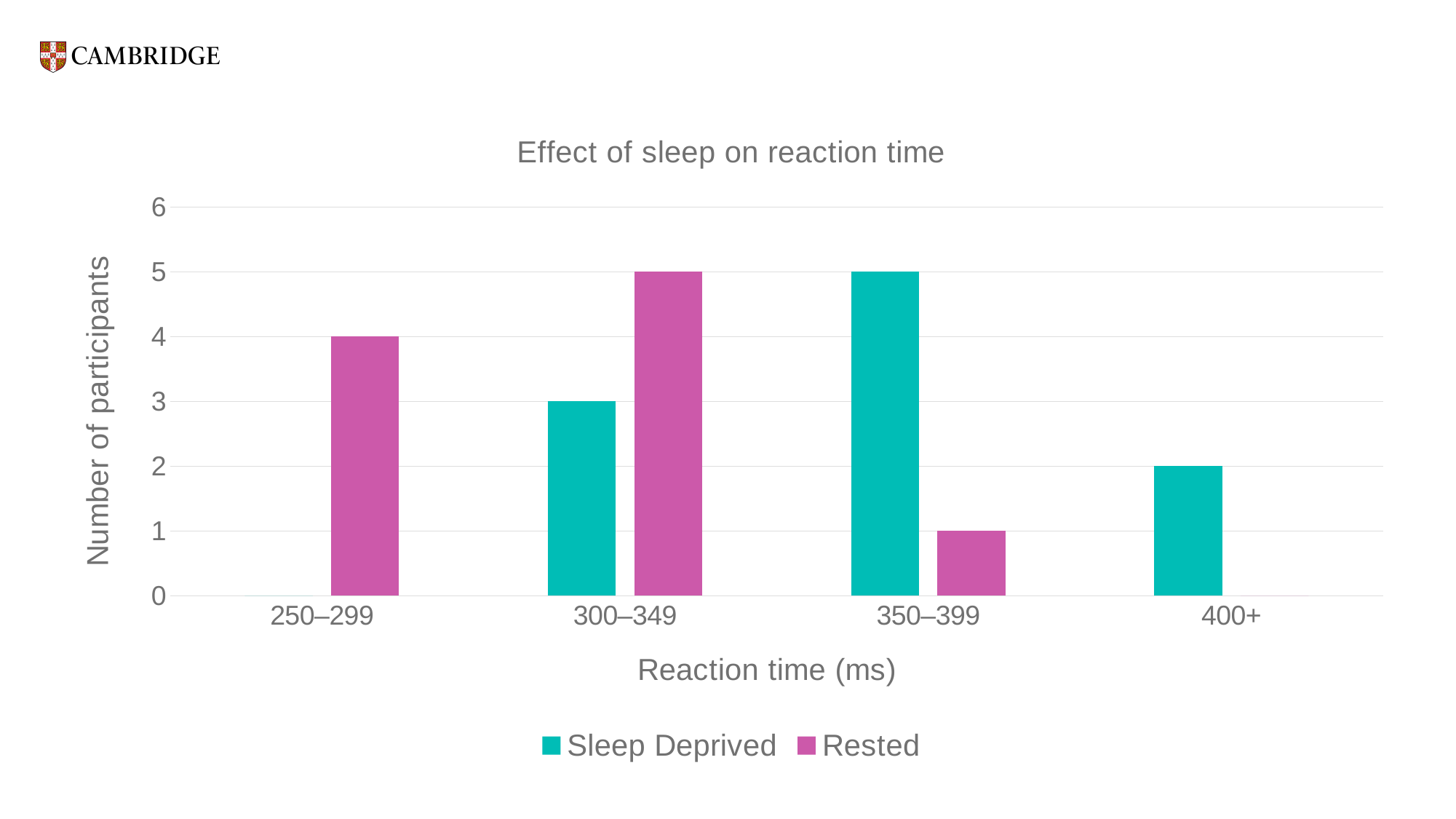
How many series does the legend list? 2 Which reaction time category has the highest number of Rested participants? 300–349 What type of chart is shown on the slide? bar chart Which reaction time category has the lowest number of Sleep Deprived participants? 250–299 Do the Rested values rise or fall from the 300–349 category to the 400+ category? fall In the 300–349 ms category, which series has more participants, Sleep Deprived or Rested? Rested How many Sleep Deprived participants had a reaction time of 350–399 ms? 5 What is the title of the chart? Effect of sleep on reaction time What is the difference between the number of Sleep Deprived and Rested participants in the 350–399 ms category? 4 How many Rested participants had a reaction time of 250–299 ms? 4 How many reaction time categories are shown on the x axis? 4 How many Sleep Deprived participants had a reaction time of 400+ ms? 2